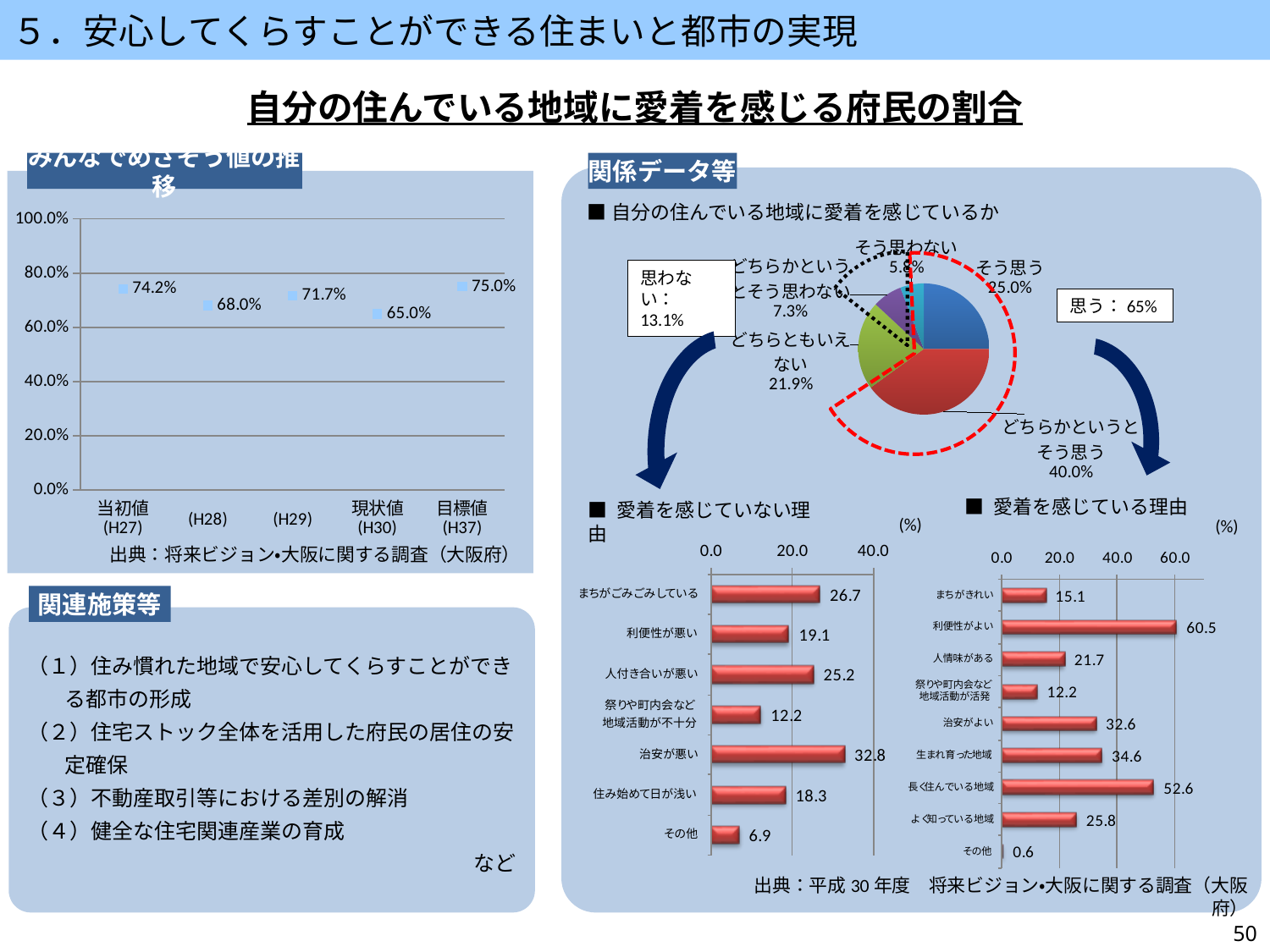
In the chart titled みんなでめざそう値の推移, which category has the lowest value? 現状値 (H30) In the chart 愛着を感じている理由, which category has the highest value? 利便性がよい In the pie chart 自分の住んでいる地域に愛着を感じているか, how many slices are there? 5 In the chart titled みんなでめざそう値の推移, what is the value for 目標値 (H37)? 75.0% What kind of chart is 愛着を感じている理由? Bar chart In the pie chart 自分の住んでいる地域に愛着を感じているか, what share does どちらかというとそう思う have? 40.0% In the chart 愛着を感じていない理由, what is the difference between まちがごみごみしている and 利便性が悪い? 7.6 In the pie chart 自分の住んでいる地域に愛着を感じているか, which slice is the smallest? そう思わない In the chart 愛着を感じている理由, which is larger, 生まれ育った地域 or 治安がよい? 生まれ育った地域 In the chart 愛着を感じていない理由, what is the value for 治安が悪い? 32.8 In the chart titled みんなでめざそう値の推移, how many data points are plotted? 5 In the chart titled みんなでめざそう値の推移, what is the value for 当初値 (H27)? 74.2%